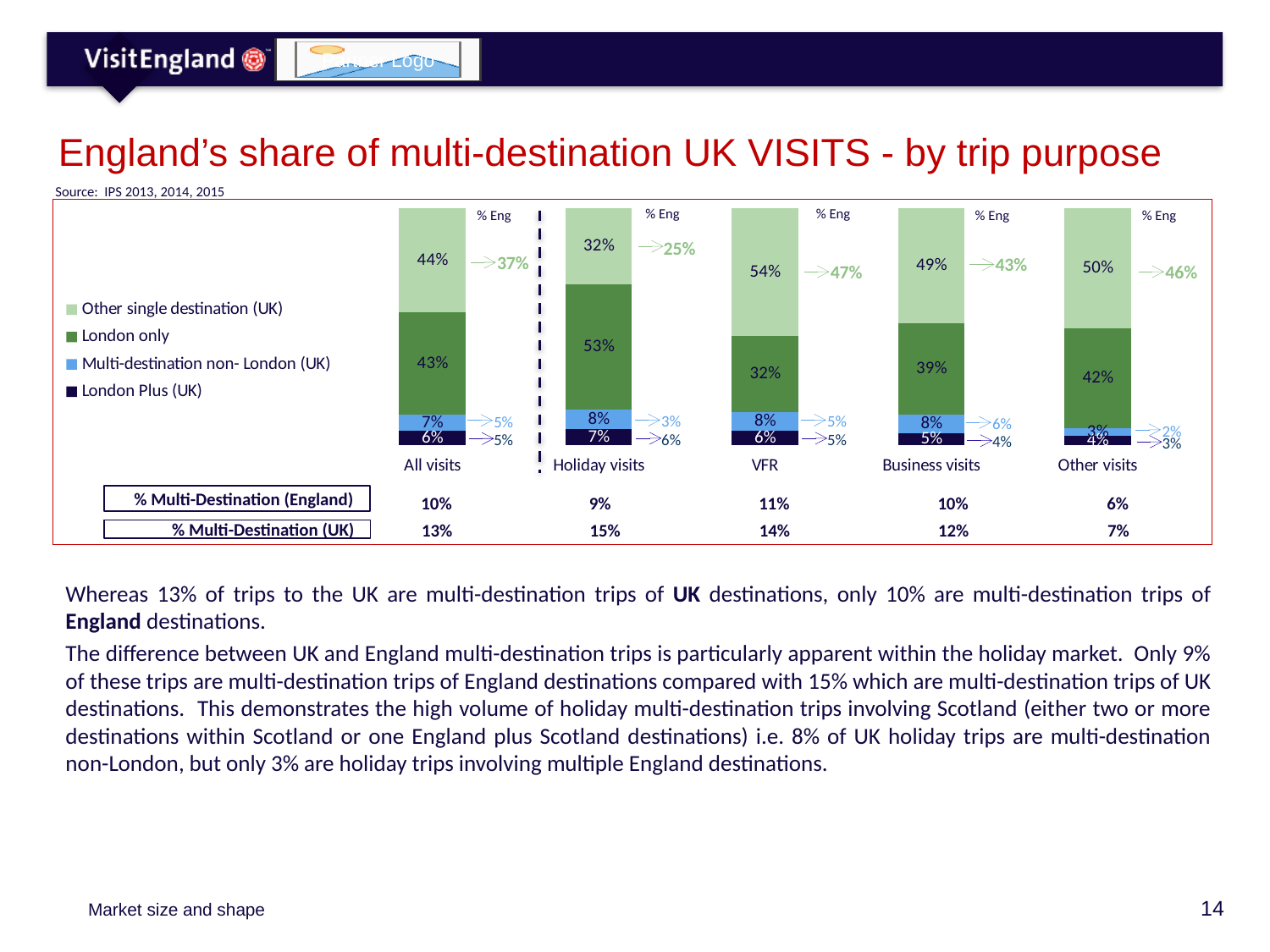
Which category has the highest 'London only' value? Holiday visits What is the 'Multi-destination non- London (UK)' value for Other visits? 3% What is the 'London Plus (UK)' value for Business visits? 5% What is the '% Multi-Destination (UK)' figure shown for Holiday visits? 15% What kind of chart is shown on the slide? Stacked bar chart Which is larger: the 'London only' value for All visits or for Business visits? All visits What is the 'Other single destination (UK)' value for VFR? 54% What is the difference between the 'Other single destination (UK)' values for VFR and Holiday visits? 22% Which category has the lowest 'Other single destination (UK)' value? Holiday visits What is the 'London only' value for Holiday visits? 53% How many trip-purpose categories are plotted along the x axis? 5 How many series does the legend list? 4